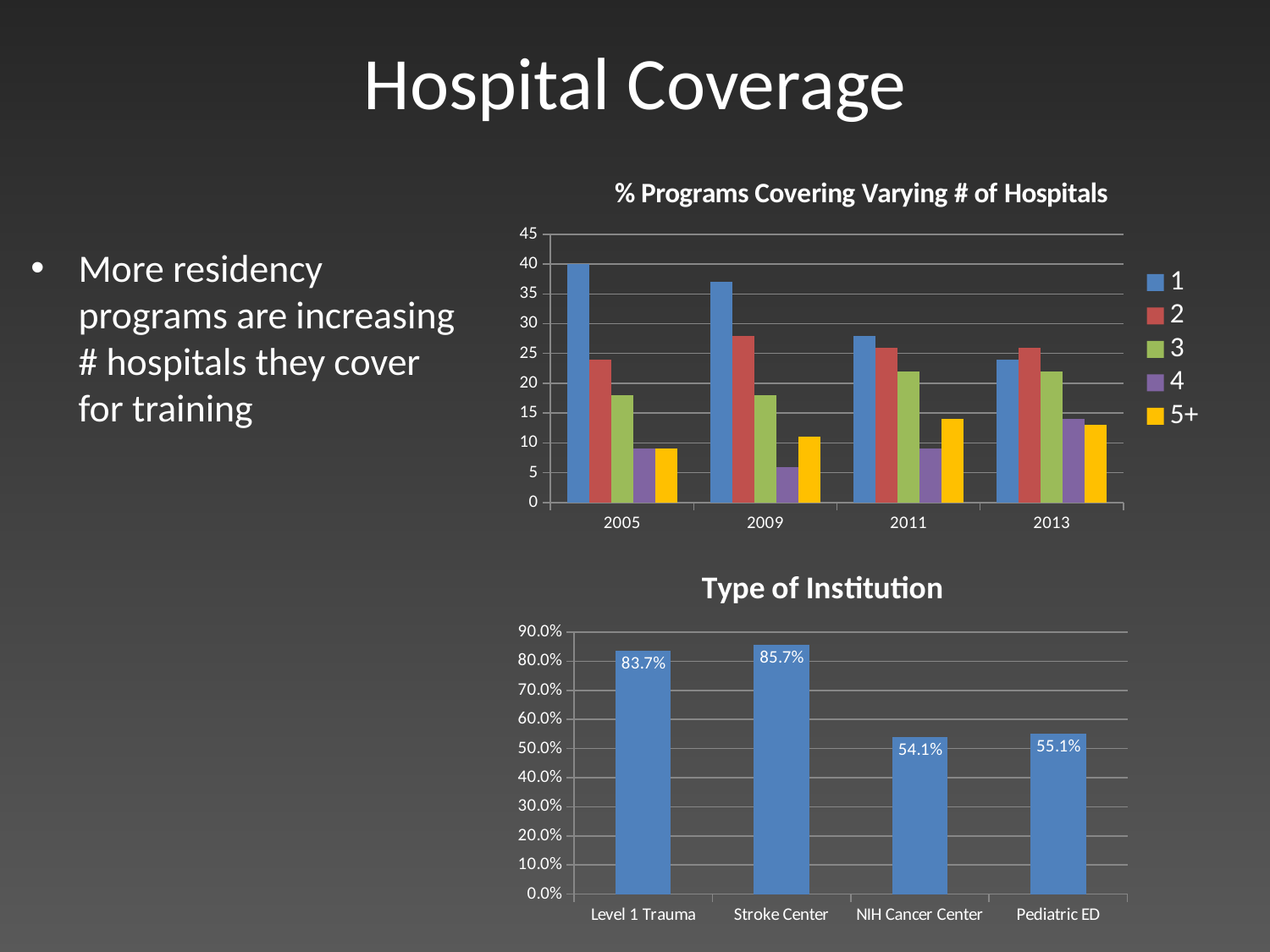
In the '% Programs Covering Varying # of Hospitals' chart, does the value for series '1' rise or fall from 2005 to 2013? fall In the '% Programs Covering Varying # of Hospitals' chart, is the value for series '4' in 2009 greater or less than 10? less In the 'Type of Institution' chart, which institution type has the lowest value? NIH Cancer Center In the '% Programs Covering Varying # of Hospitals' chart, which is larger in 2005: series '1' or series '2'? 1 How many institution types are shown in the 'Type of Institution' chart? 4 In the 'Type of Institution' chart, which institution type has the highest value? Stroke Center How many series does the legend of the '% Programs Covering Varying # of Hospitals' chart list? 5 In the 'Type of Institution' chart, what is the value for Level 1 Trauma? 83.7% In the '% Programs Covering Varying # of Hospitals' chart, what is the value for series '1' in 2005? 40 In the 'Type of Institution' chart, what is the value for Stroke Center? 85.7% What kind of chart is the '% Programs Covering Varying # of Hospitals' chart? bar chart In the 'Type of Institution' chart, what is the difference between the Stroke Center value and the NIH Cancer Center value? 31.6 percentage points